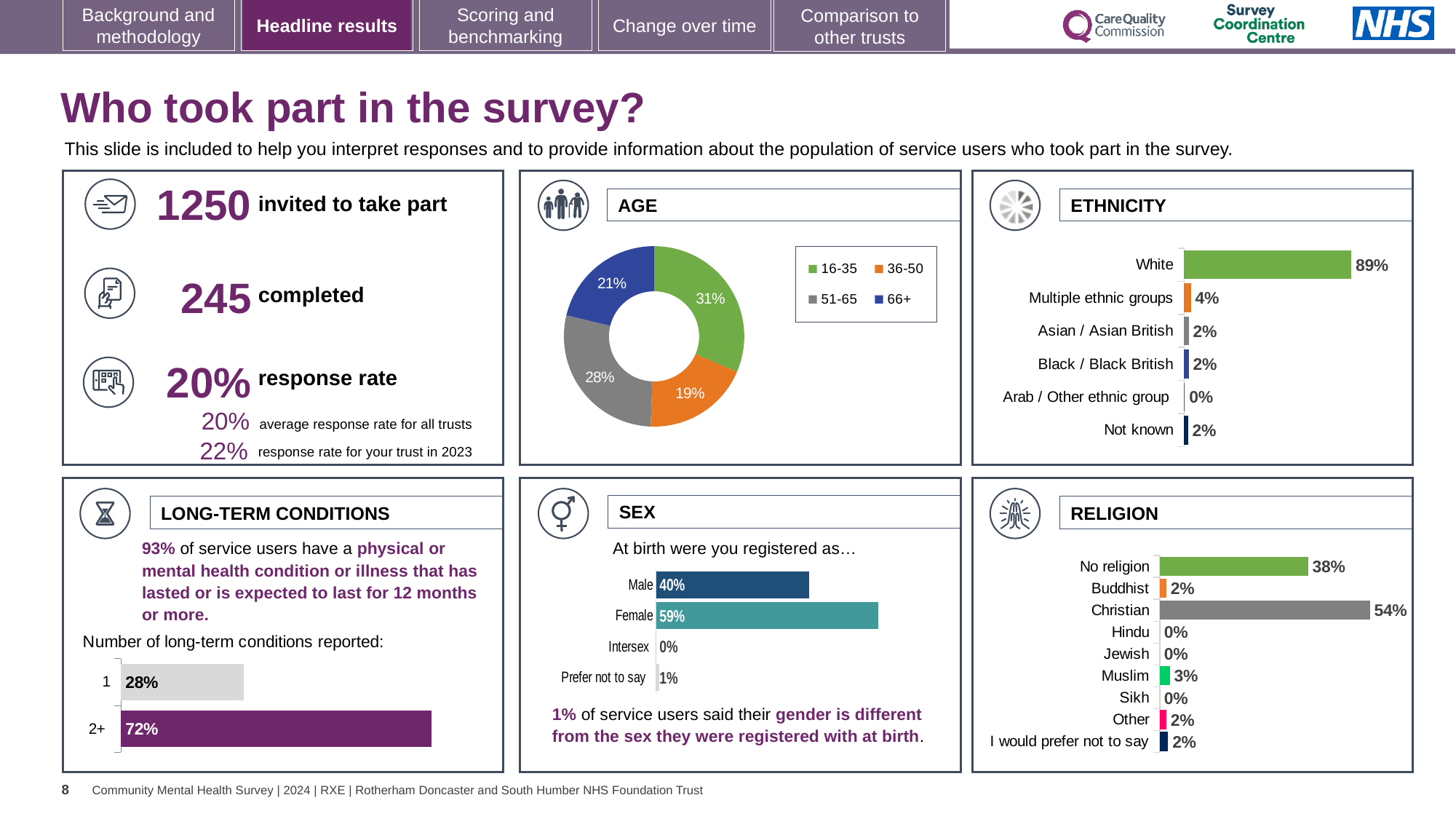
In the SEX chart, what is the value for Prefer not to say? 1% How many age groups does the legend of the AGE chart list? 4 In the ETHNICITY chart, which category has the highest value? White What kind of chart is the AGE chart? Donut (pie) chart In the RELIGION chart, which category has the highest value? Christian How many categories are shown in the ETHNICITY chart? 6 In the AGE chart, which age group has the smallest share? 36-50 In the ETHNICITY chart, what is the difference between White and Multiple ethnic groups? 85% In the ETHNICITY chart, what is the value for Multiple ethnic groups? 4% In the SEX chart, which is larger, Male or Female? Female In the LONG-TERM CONDITIONS chart, what percentage of service users reported 2+ long-term conditions? 72% In the AGE chart, what share of respondents were aged 16-35? 31%